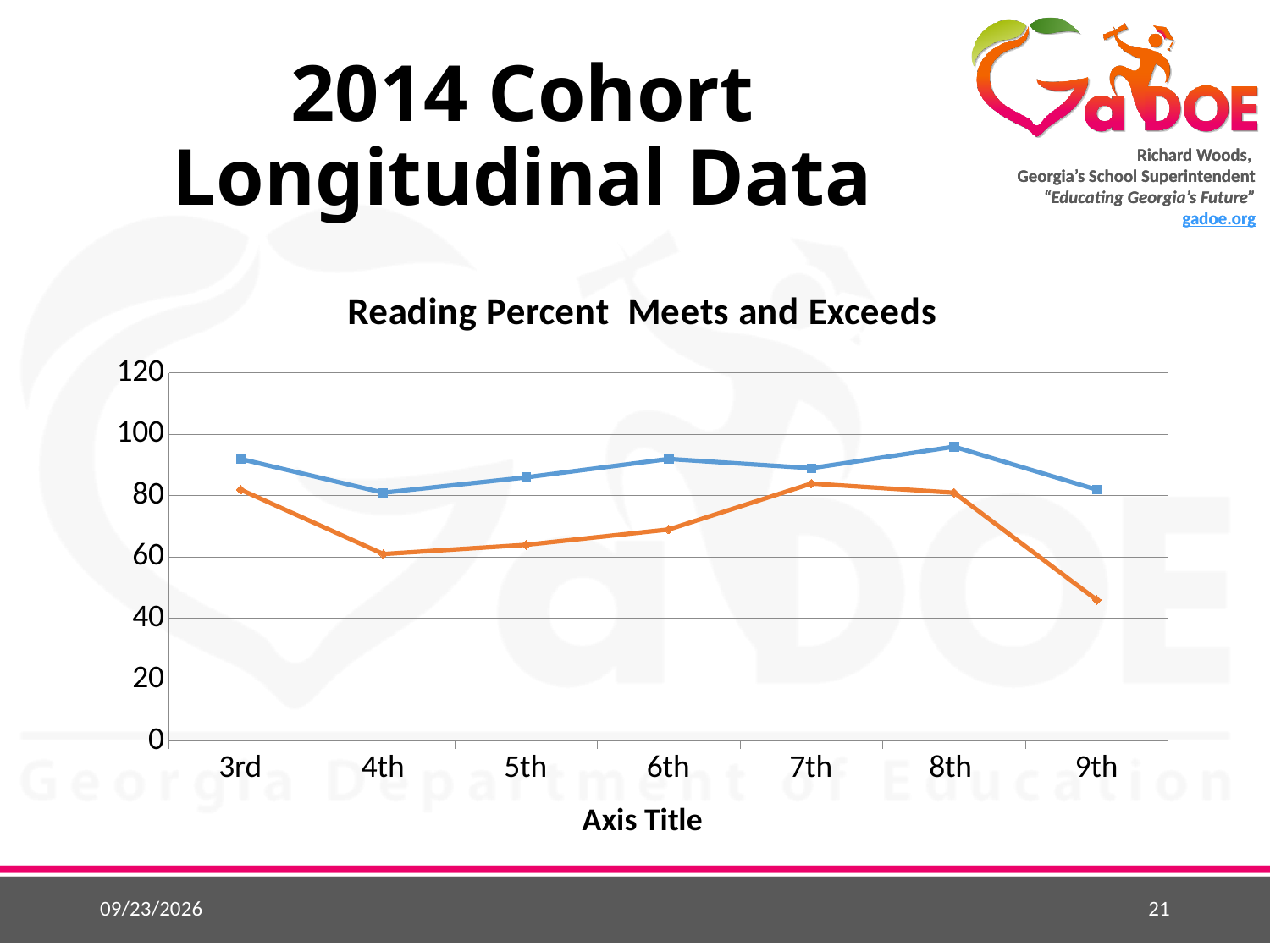
Is the value of the orange line at 9th greater or less than 60? less What is the title of the chart? Reading Percent Meets and Exceeds Is the value of the orange line at 4th greater or less than 80? less What kind of chart is shown on the slide? line chart At 4th, which line has the higher value, the blue line or the orange line? blue line What is the label shown on the x axis? Axis Title At which grade does the orange line reach its lowest value? 9th How many grade-level categories are shown on the x axis? 7 Is the value of the blue line at 8th greater or less than 80? greater Does the orange line rise or fall from 8th to 9th? fall At 9th, which line has the higher value, the blue line or the orange line? blue line